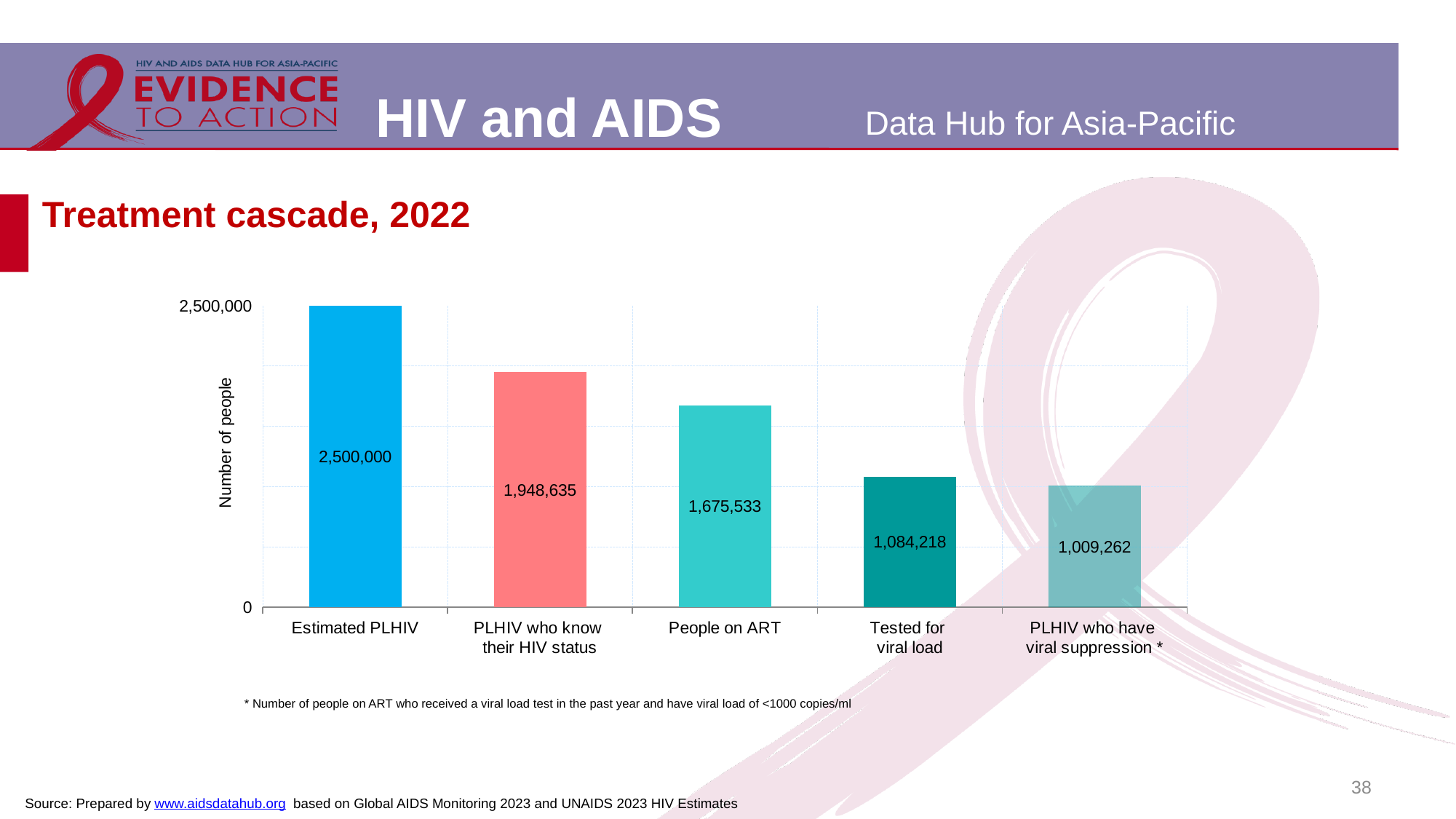
What is the difference between Estimated PLHIV and PLHIV who know their HIV status? 551,365 What is the value for PLHIV who know their HIV status? 1,948,635 What is the difference between People on ART and Tested for viral load? 591,315 What is the value for People on ART? 1,675,533 What is the value for Estimated PLHIV? 2,500,000 Which category has the lowest value? PLHIV who have viral suppression Do the values rise or fall from left to right along the x axis? fall What is the value for Tested for viral load? 1,084,218 Which is larger, People on ART or Tested for viral load? People on ART Which category has the highest value? Estimated PLHIV How many categories are shown in the chart? 5 What is the value for PLHIV who have viral suppression? 1,009,262